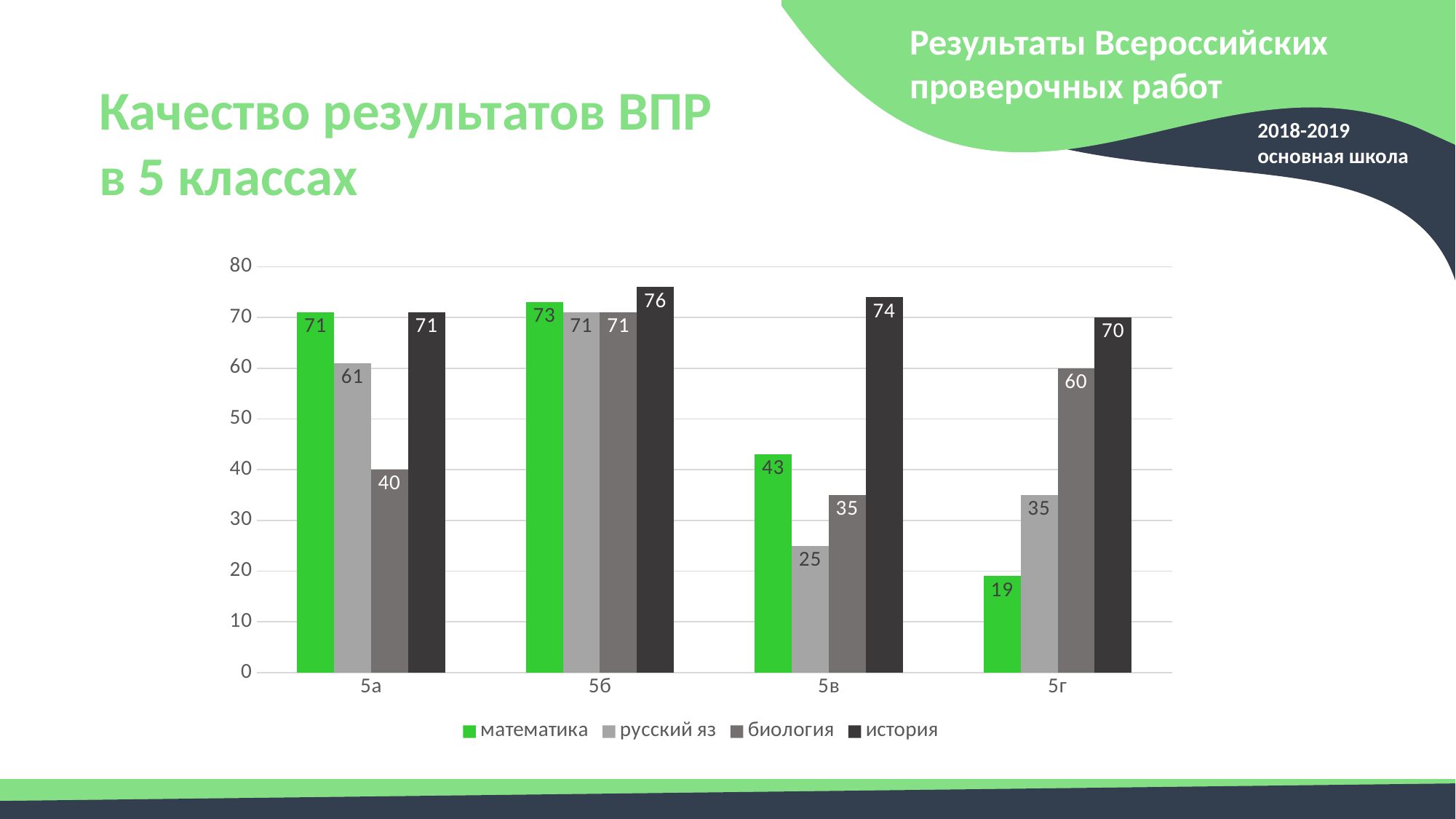
Which class has the highest value for история? 5б What is the value for биология in class 5г? 60 How many series does the legend list? 4 Do the математика values rise or fall from 5б to 5г along the x axis? fall How many classes are shown on the x axis? 4 What kind of chart is shown on the slide? bar chart What is the difference between the история and русский яз values in class 5в? 49 What is the value for математика in class 5а? 71 Which series is shown in green in the legend? математика Which is larger in class 5г: the value for биология or the value for русский яз? биология Which class has the lowest value for математика? 5г What is the value for русский яз in class 5в? 25